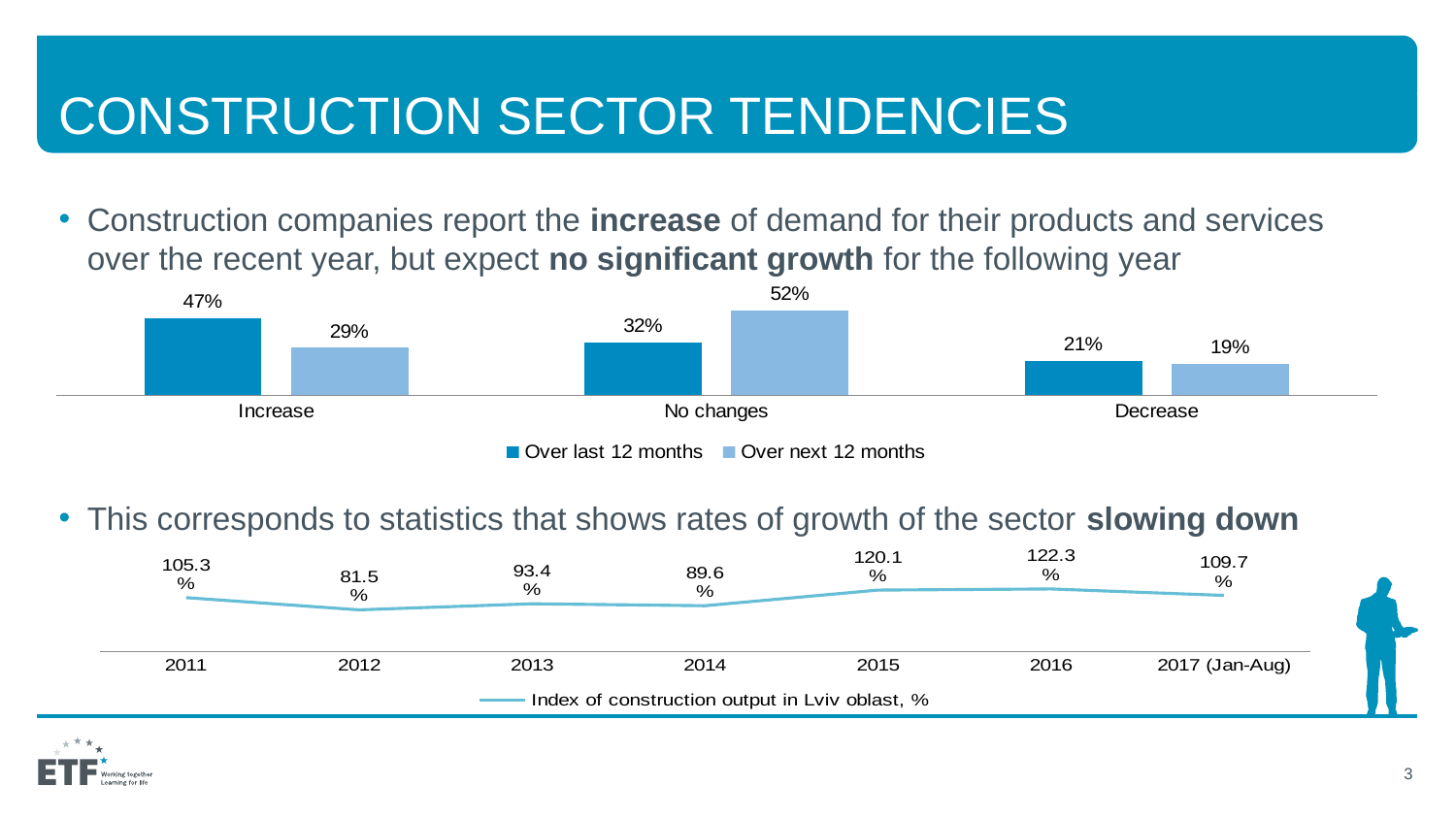
In the top bar chart, what is the value for 'Decrease' in the 'Over next 12 months' series? 19% In the bottom line chart, which year has the lowest index of construction output? 2012 In the top bar chart, what is the value for 'Increase' in the 'Over last 12 months' series? 47% What kind of chart is the top chart on the slide? Bar chart In the bottom line chart, what is the index of construction output in Lviv oblast for 2016? 122.3% In the bottom line chart, what is the difference between the 2016 and 2017 (Jan-Aug) values? 12.6% In the top bar chart, what is the value for 'No changes' in the 'Over next 12 months' series? 52% In the top bar chart, which is larger for 'No changes': 'Over last 12 months' or 'Over next 12 months'? Over next 12 months How many series does the legend of the top bar chart list? 2 In the bottom line chart, how many data points are plotted? 7 In the top bar chart, what is the difference between the 'Over last 12 months' and 'Over next 12 months' values for 'Increase'? 18% In the top bar chart, which category has the highest value in the 'Over last 12 months' series? Increase